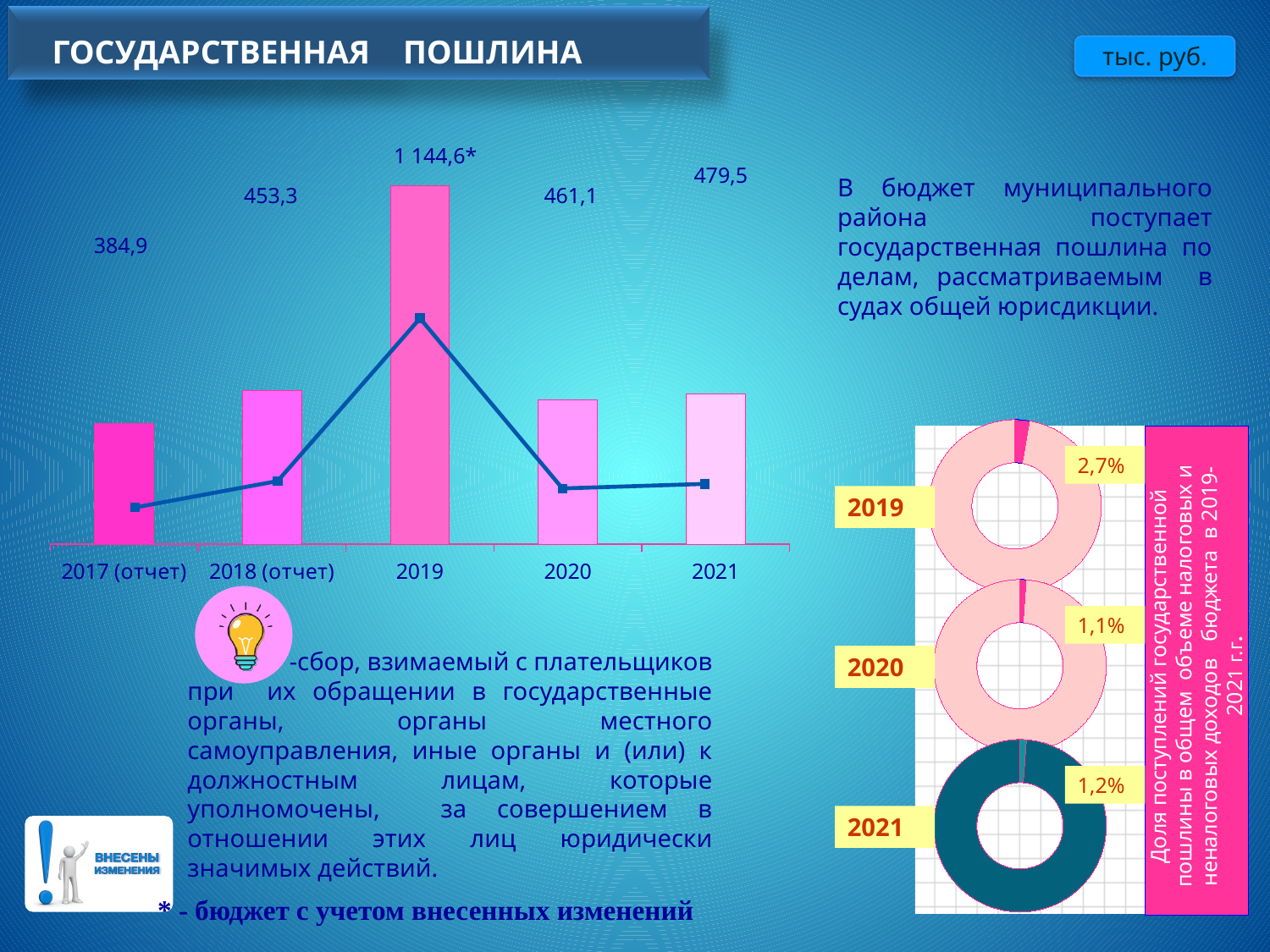
What kind of chart is the main chart on the left of the slide? Bar chart with a line overlay In the bar chart on the left, what is the value labelled for 2019? 1 144,6* In the bar chart on the left, which year has the highest value? 2019 In the bar chart on the left, what is the difference between the values for 2021 and 2020? 18,4 In the donut charts on the right, what share is shown for 2019? 2,7% In the bar chart on the left, which year has the lowest value? 2017 (отчет) In the bar chart on the left, what is the value for 2017 (отчет)? 384,9 In the donut charts on the right, what share is shown for 2020? 1,1% In the bar chart on the left, what is the value for 2021? 479,5 How many years (categories) are shown in the bar chart on the left? 5 In the bar chart on the left, what is the difference between the values for 2018 (отчет) and 2017 (отчет)? 68,4